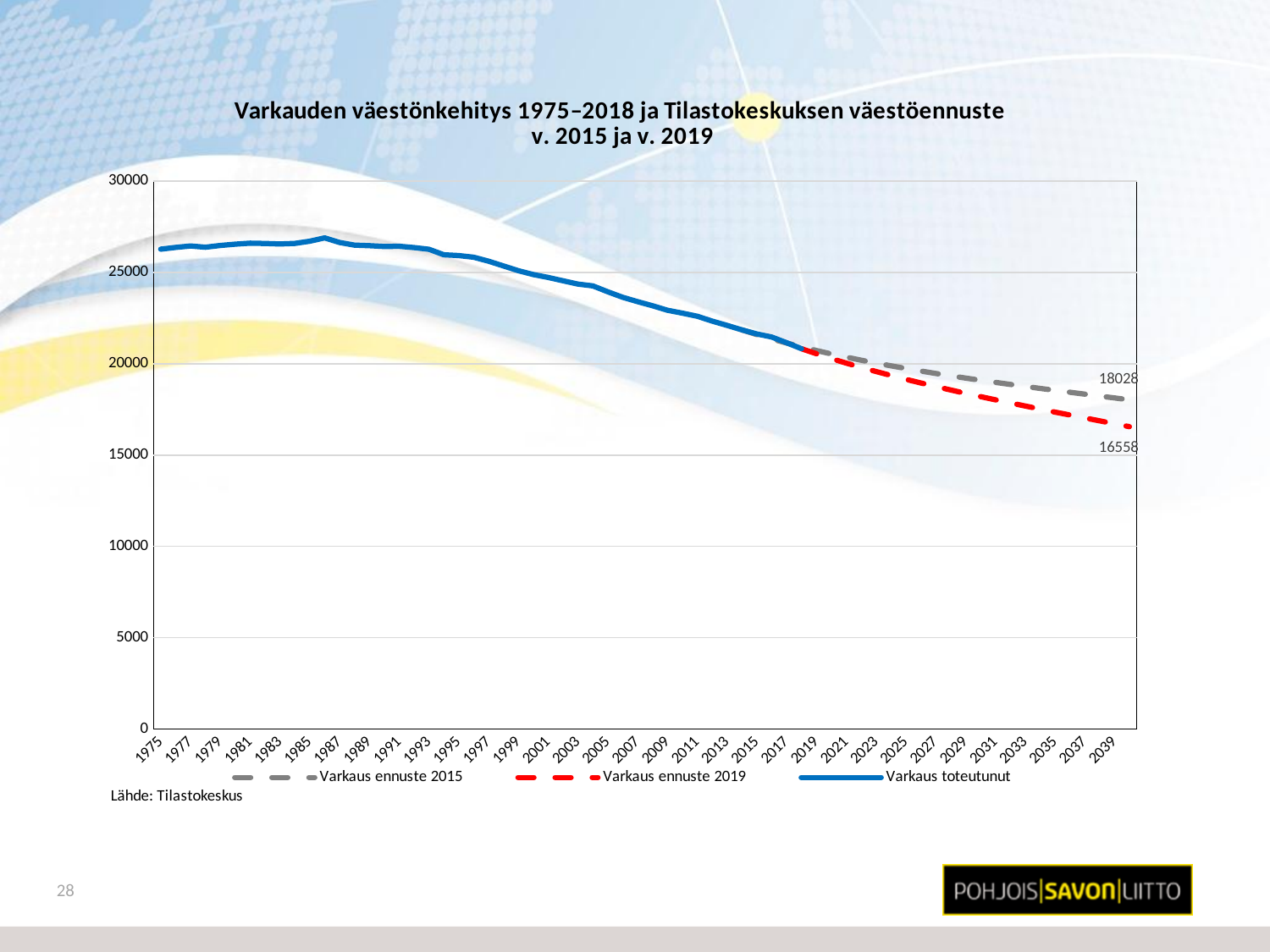
How many series does the legend list? 3 What is the final labelled value of the Varkaus ennuste 2015 series? 18028 What kind of chart is shown on the slide? line chart Is the value for Varkaus ennuste 2019 at the end of the forecast greater or less than 20000? less What is the final labelled value of the Varkaus ennuste 2019 series? 16558 What colour is the Varkaus ennuste 2019 line? red Is the value for Varkaus toteutunut in 1975 greater or less than 25000? greater What is the difference between the final labelled values of Varkaus ennuste 2015 and Varkaus ennuste 2019? 1470 Between 2000 and 2018, does the Varkaus toteutunut line rise or fall? fall Is the value for Varkaus toteutunut in 2017 greater or less than 20000? greater Which forecast series ends at a higher value, Varkaus ennuste 2015 or Varkaus ennuste 2019? Varkaus ennuste 2015 What source is cited below the chart? Tilastokeskus